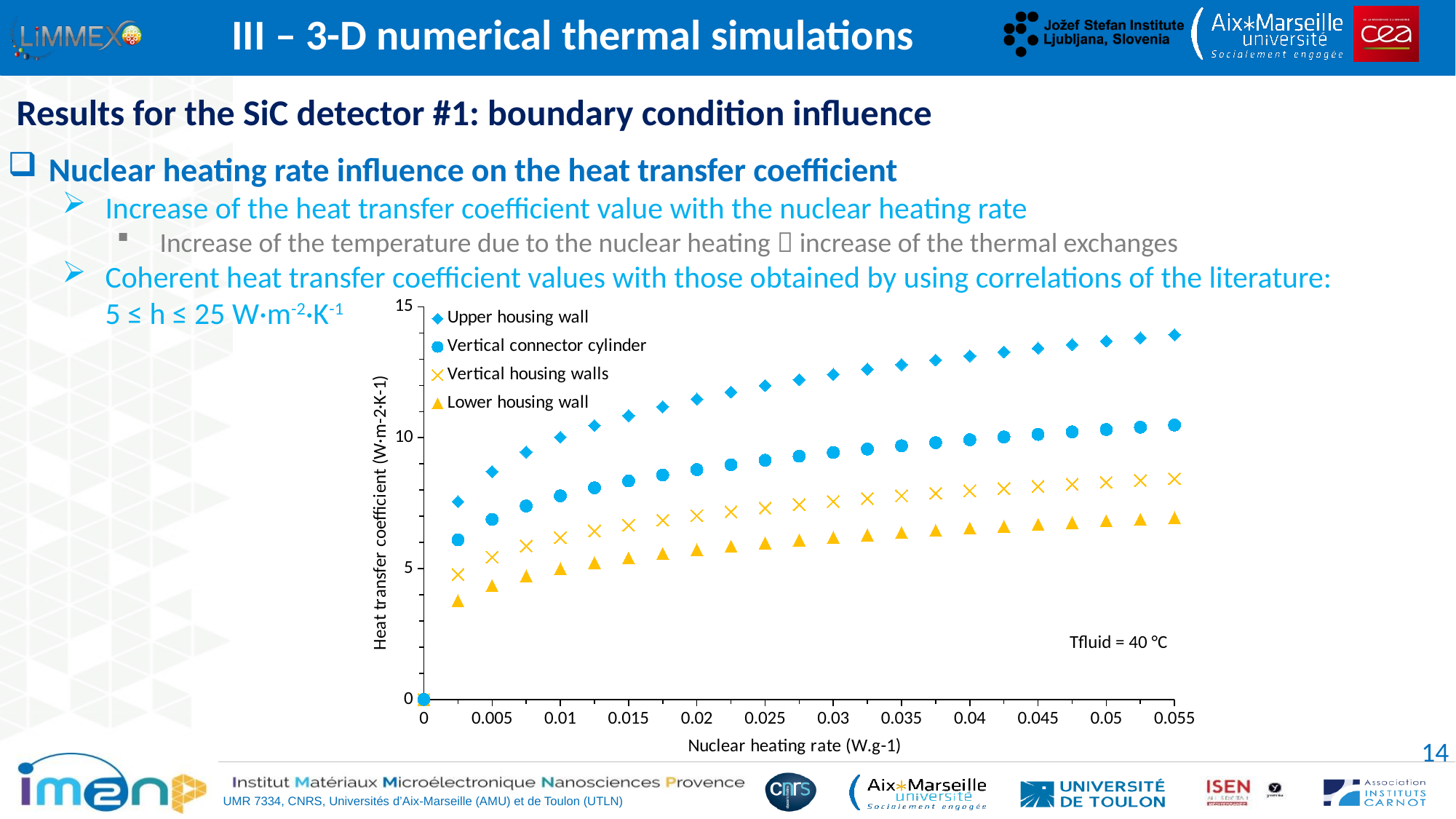
Which series has the highest heat transfer coefficient values across the nuclear heating rate range? Upper housing wall At a nuclear heating rate of 0.03, which is larger: the heat transfer coefficient for the Upper housing wall or for the Vertical connector cylinder? Upper housing wall Is the heat transfer coefficient for the Lower housing wall at a nuclear heating rate of 0.055 greater or less than 5? greater What kind of chart is shown on the slide? scatter chart Is the heat transfer coefficient for the Upper housing wall at a nuclear heating rate of 0.055 greater or less than 10? greater Is the heat transfer coefficient for the Vertical housing walls at a nuclear heating rate of 0.055 greater or less than 10? less What is the label of the x axis of the chart? Nuclear heating rate (W.g-1) How many series does the chart legend list? 4 What fluid temperature is annotated on the chart? Tfluid = 40 °C Does the heat transfer coefficient for the Upper housing wall rise or fall as the nuclear heating rate increases? rise Which series has the lowest heat transfer coefficient values across the nuclear heating rate range? Lower housing wall